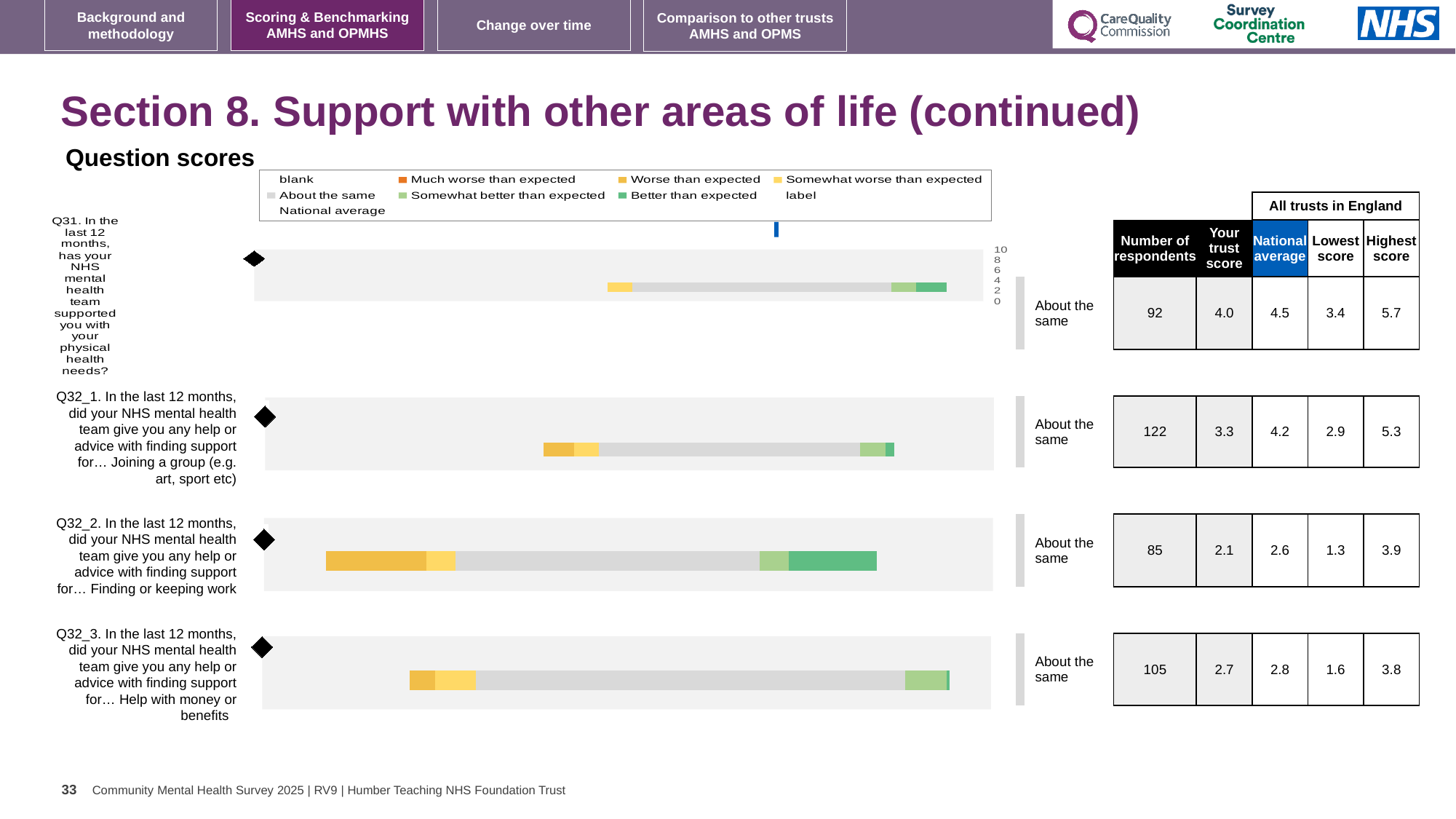
Which question has the highest 'Your trust score'? Q31 What benchmark category is shown next to the bar for Q32_2 (Finding or keeping work)? About the same What is the 'Your trust score' value for Q31 (support with physical health needs)? 4.0 How many question bars are plotted in the question scores chart? 4 What kind of chart is used to show the question scores on this slide? bar chart How many entries does the legend of the question scores chart list? 9 Is the trust score for Q32_3 (Help with money or benefits) larger or smaller than the trust score for Q32_2 (Finding or keeping work)? larger Which question has the lowest 'Your trust score'? Q32_2 In the question scores chart, which legend entry is shown in grey? About the same How many respondents answered Q32_3 (Help with money or benefits)? 105 What is the national average for Q32_1 (Joining a group)? 4.2 What is the difference between the national average and the trust score for Q32_1 (Joining a group)? 0.9